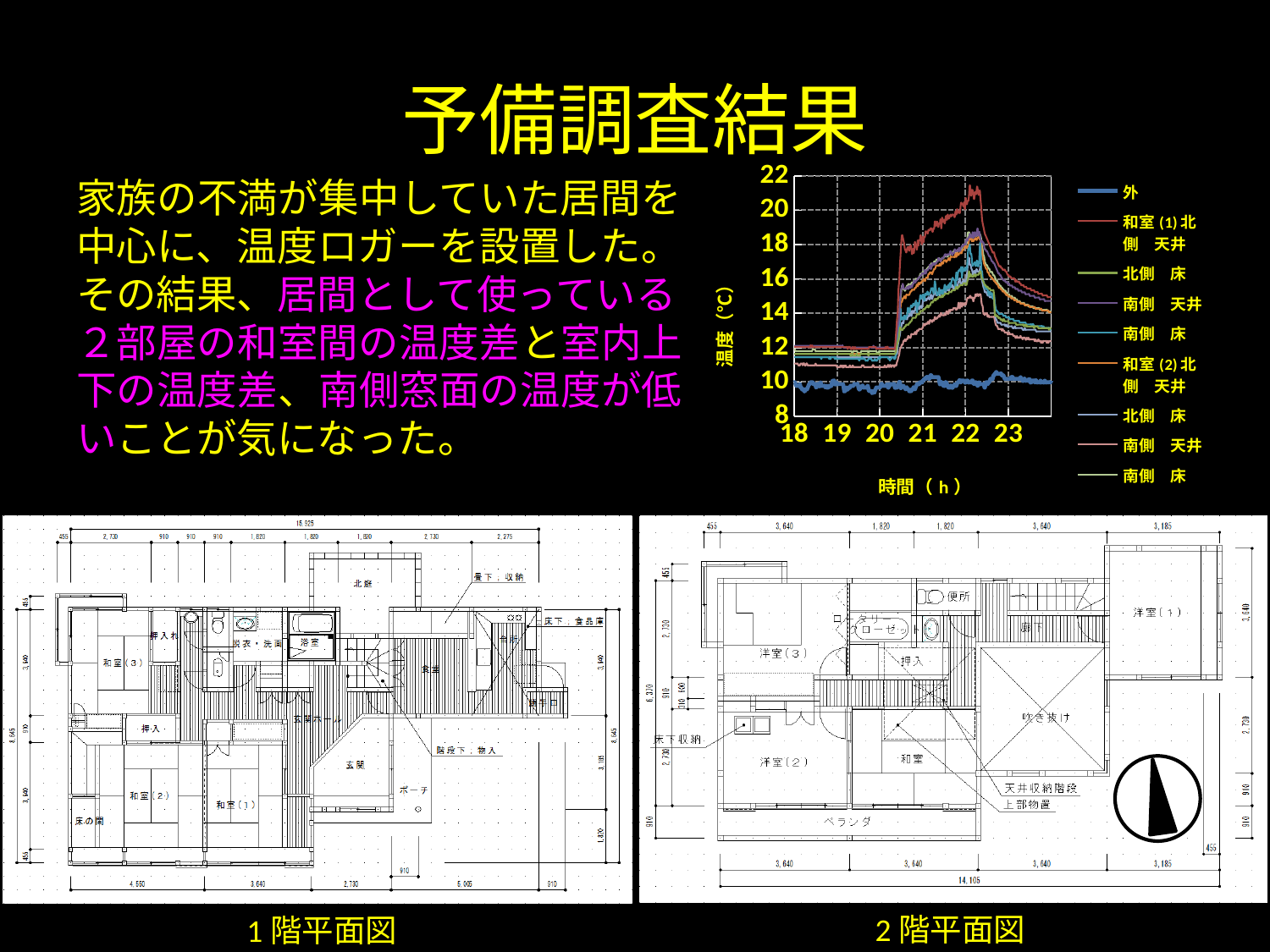
What kind of chart is shown on the slide? line chart How many series does the chart's legend list? 9 Which series reaches the highest temperature on the chart? 和室(1)北側 天井 Is the value for 外 at hour 22 greater or less than 14? less Is the peak value for 和室(1)北側 天井 near hour 22 greater or less than 20? greater Which series stays the lowest throughout the chart? 外 After hour 22, do the indoor temperature series rise or fall? fall Is the value for 外 at hour 20 greater or less than 12? less Between hour 20 and hour 22, do the indoor temperature series rise or fall? rise How many hour ticks are labelled on the chart's horizontal axis? 6 What is the label of the chart's horizontal axis? 時間 (h) What is the label of the chart's vertical axis? 温度 (°C)